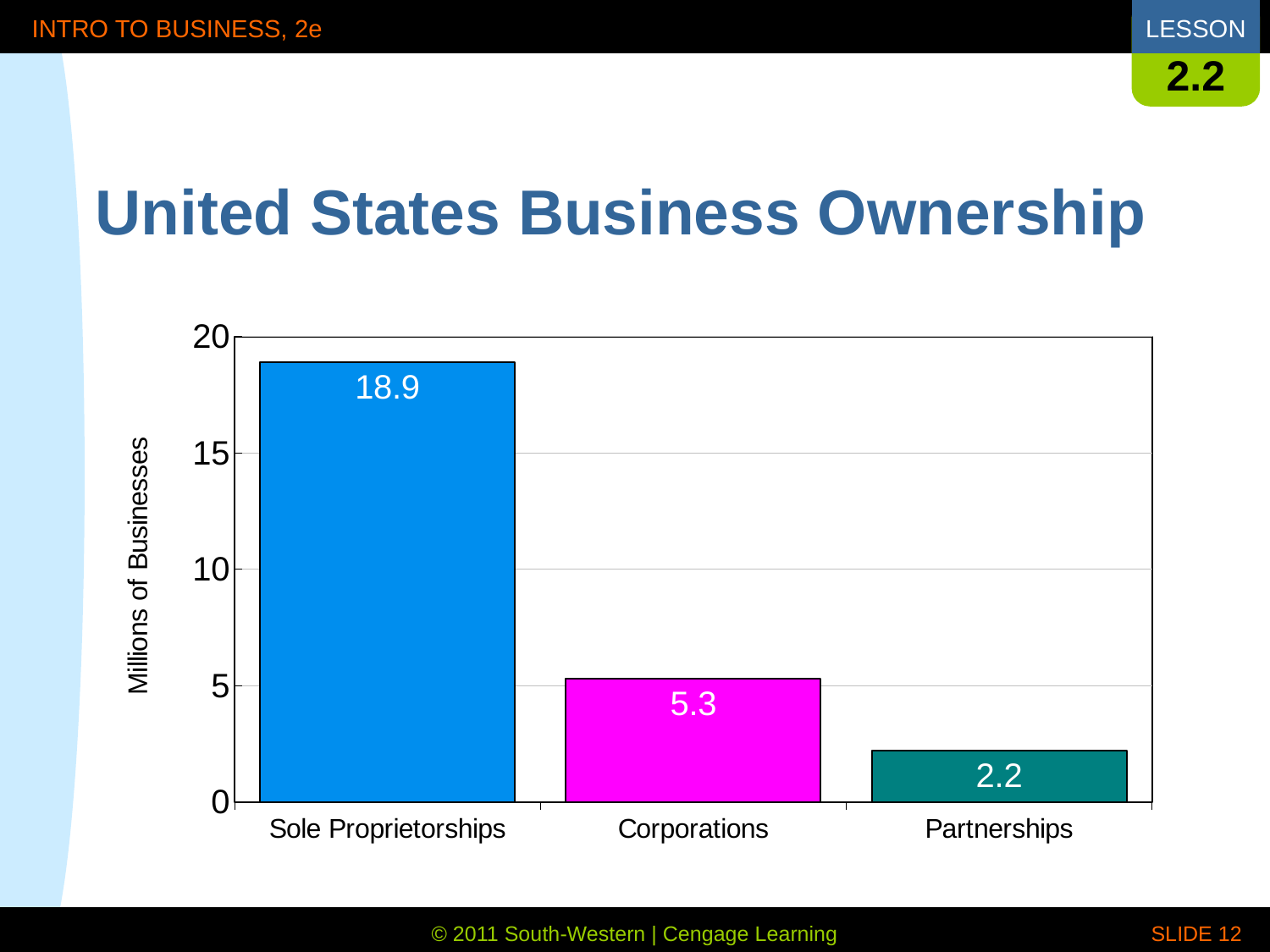
What is the value for Sole Proprietorships? 18.9 Which category has the highest value? Sole Proprietorships Is the value for Corporations greater or less than 10? less What is the difference between the values for Corporations and Partnerships? 3.1 What kind of chart is shown on the slide? bar chart How many categories are shown on the x axis? 3 What is the difference between the values for Sole Proprietorships and Corporations? 13.6 Which category has the lowest value? Partnerships What is the value for Corporations? 5.3 What is the label of the y axis? Millions of Businesses Which is larger, the value for Corporations or the value for Partnerships? Corporations What is the value for Partnerships? 2.2